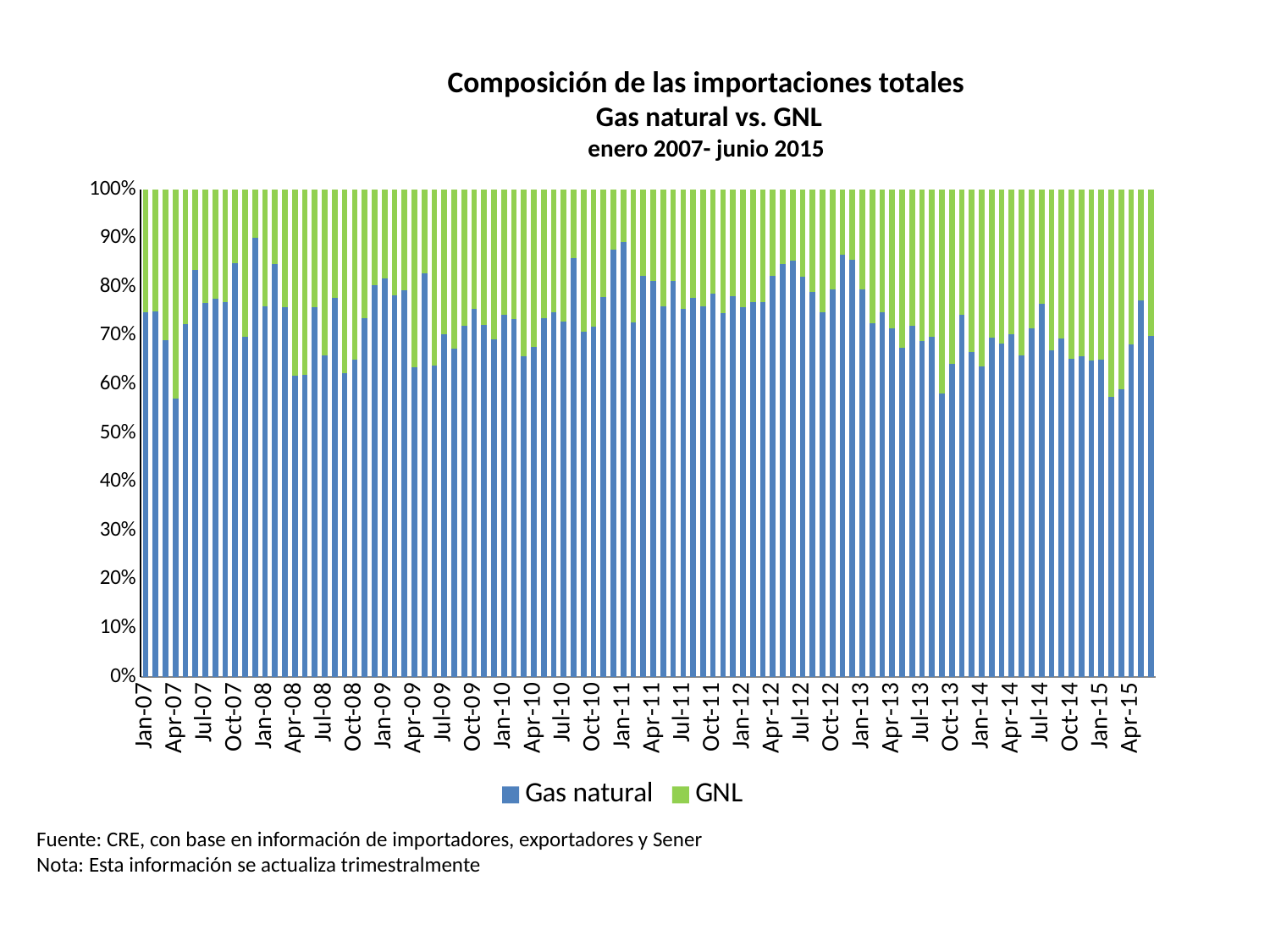
Is the Gas natural value for Jan-15 greater or less than 60%? greater What are the two series named in the legend? Gas natural and GNL What is the total of each stacked bar in the chart? 100% How many series does the legend list? 2 Is the Gas natural value for Apr-07 greater or less than 60%? less Is the Gas natural value for Jan-11 greater or less than 80%? greater What kind of chart is shown on the slide? Stacked bar chart Which colour represents GNL in the chart? Green Which has the larger GNL share, Jan-15 or Jan-11? Jan-15 Which has the larger Gas natural share, Jan-08 or Apr-07? Jan-08